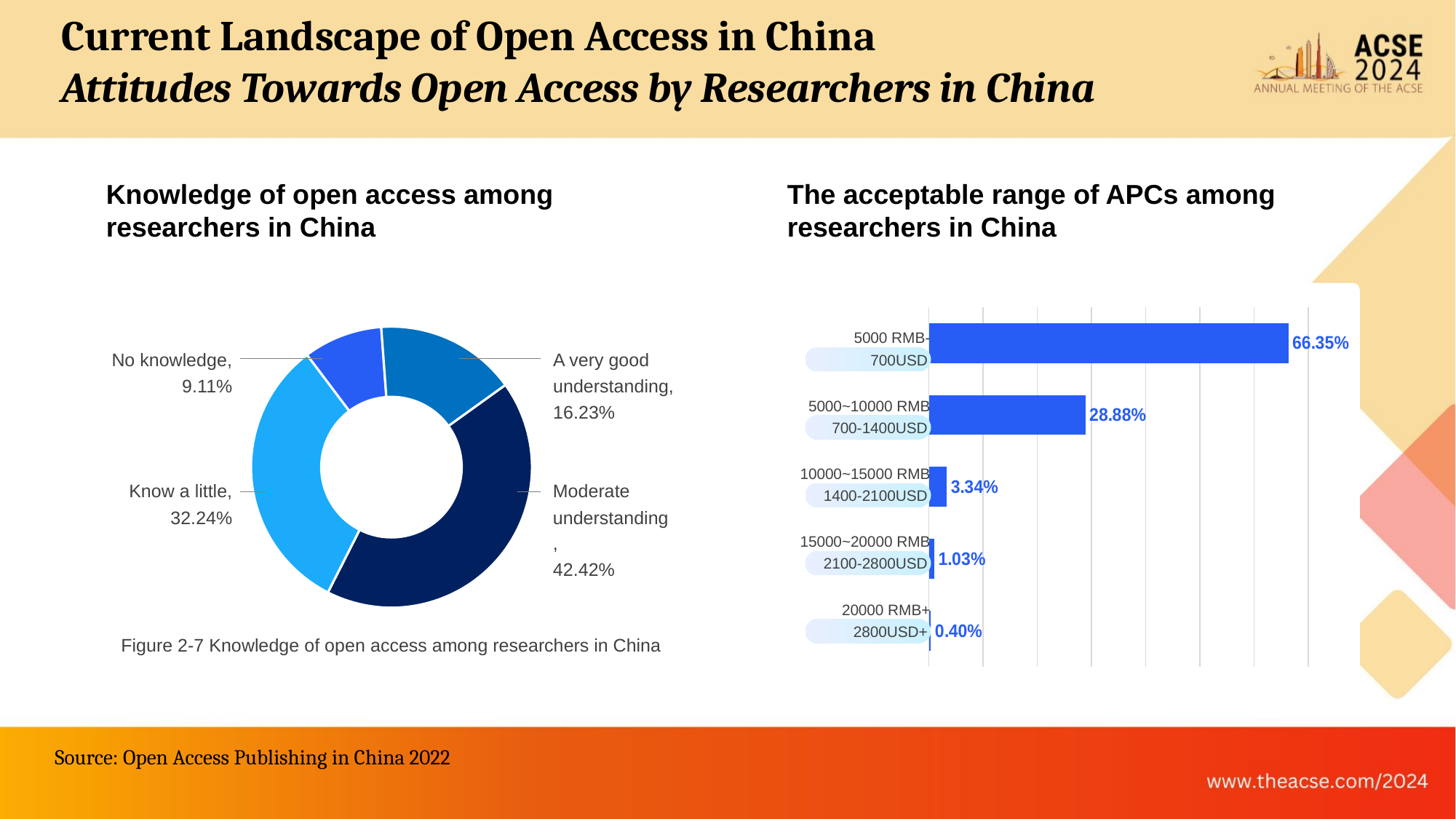
In the 'Knowledge of open access among researchers in China' chart, how many categories are shown? 4 In the 'Knowledge of open access among researchers in China' chart, what share of researchers have no knowledge of open access? 9.11% In the 'Knowledge of open access among researchers in China' chart, what share of researchers have a moderate understanding? 42.42% In the 'Knowledge of open access among researchers in China' chart, which category has the largest share? Moderate understanding What kind of chart is the 'Knowledge of open access among researchers in China' chart? Doughnut (pie) chart In 'The acceptable range of APCs among researchers in China' chart, what is the difference between the values for 5000 RMB- and 5000~10000 RMB? 37.47% In the 'Knowledge of open access among researchers in China' chart, which is larger: 'Know a little' or 'A very good understanding'? Know a little In 'The acceptable range of APCs among researchers in China' chart, what is the value for 20000 RMB+ (2800USD+)? 0.40% In the 'Knowledge of open access among researchers in China' chart, which category has the smallest share? No knowledge What kind of chart is 'The acceptable range of APCs among researchers in China' chart? Bar chart In 'The acceptable range of APCs among researchers in China' chart, what is the value for 5000~10000 RMB (700-1400USD)? 28.88% In 'The acceptable range of APCs among researchers in China' chart, which APC range has the highest value? 5000 RMB- (700USD)